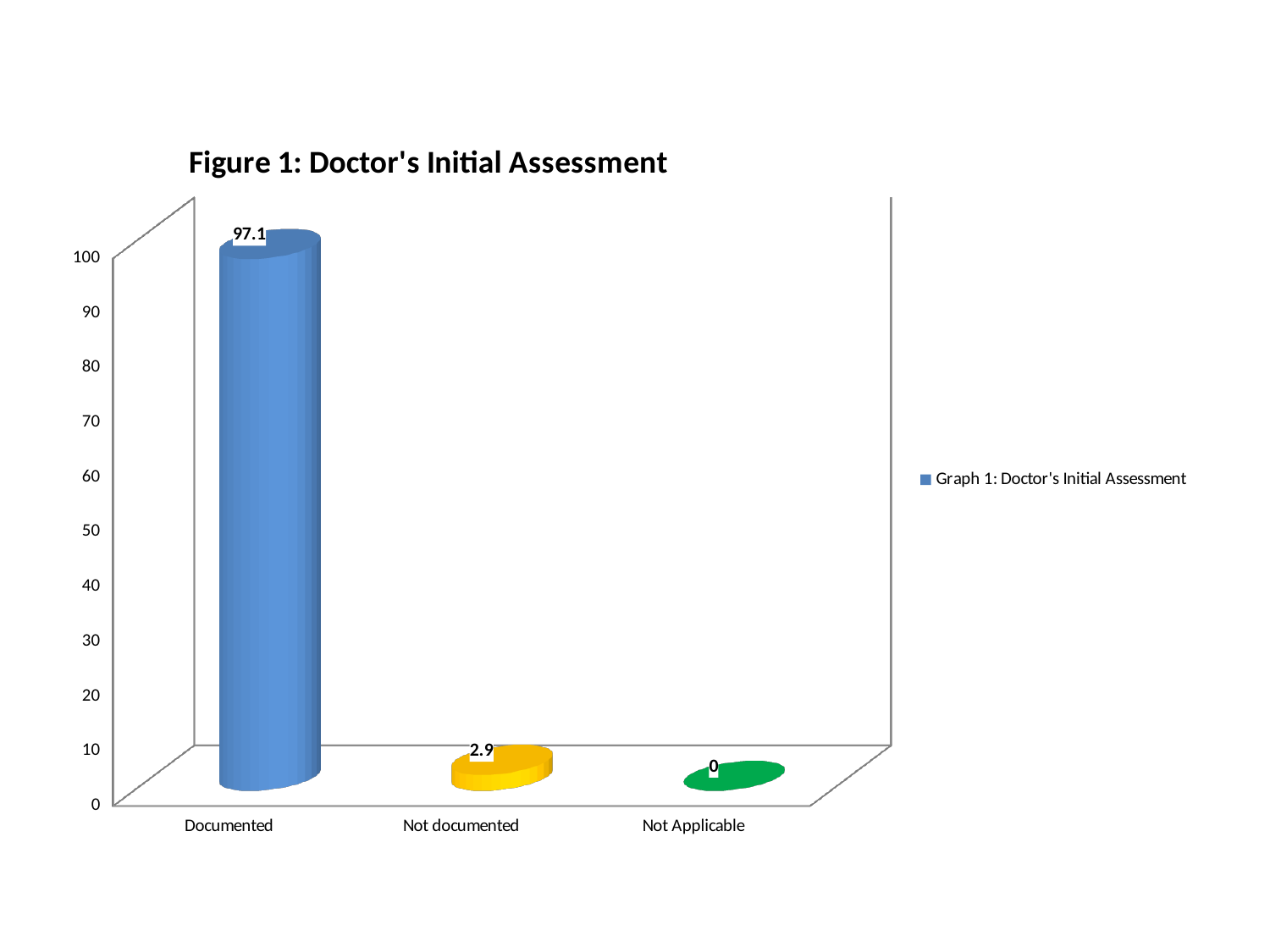
Which is larger, the value for Not documented or the value for Not Applicable? Not documented What kind of chart is shown on the slide? Bar chart What is the title of the chart? Figure 1: Doctor's Initial Assessment Which category has the lowest value? Not Applicable What is the value for Not Applicable? 0 What is the value for Documented? 97.1 What is the difference between the values for Documented and Not documented? 94.2 How many categories are shown on the x axis? 3 What is the value for Not documented? 2.9 Is the value for Documented greater or less than 90? greater How many series does the legend list? 1 Which category has the highest value? Documented